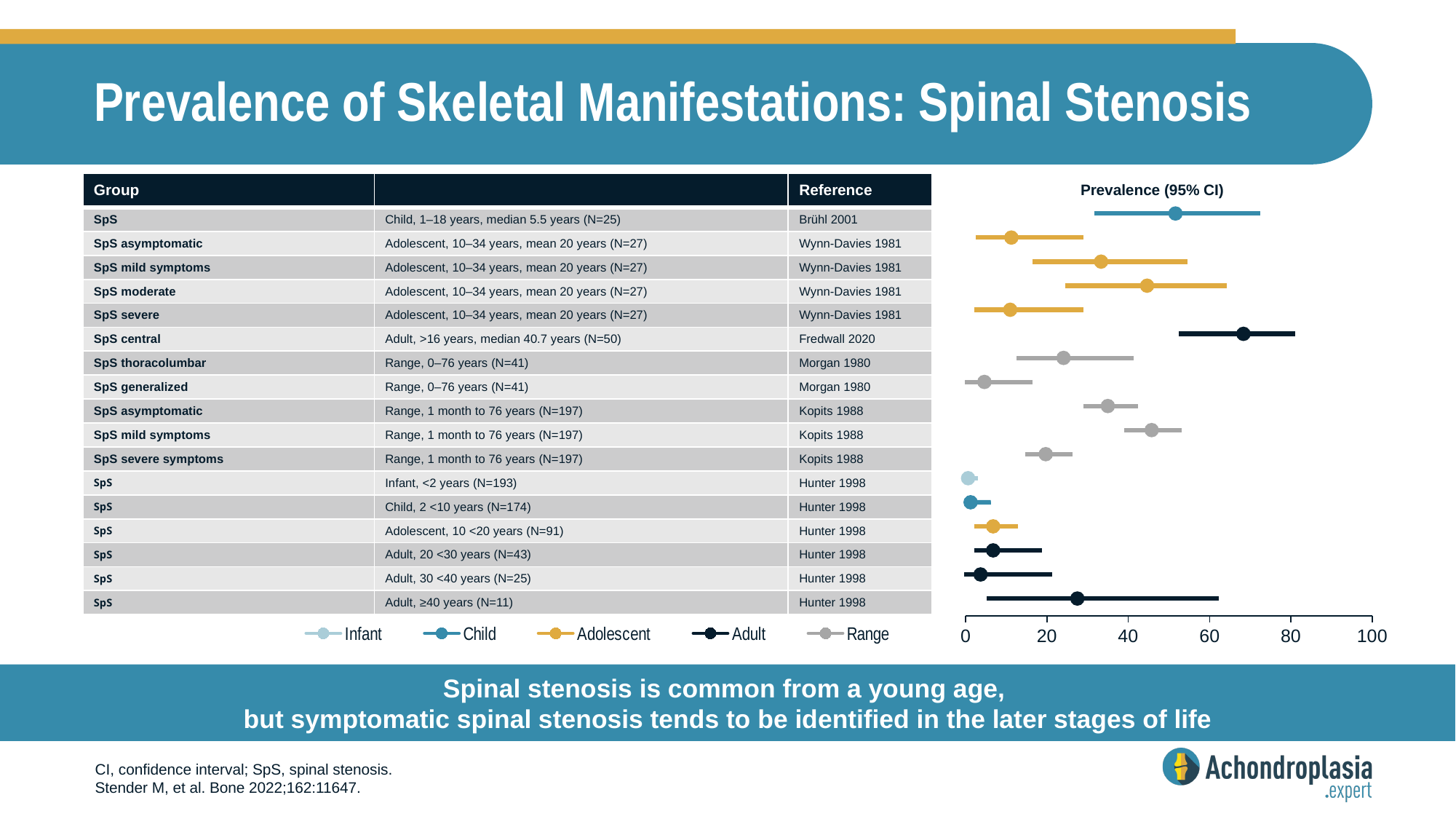
What kind of chart is shown on the right of the slide? A forest plot (dot plot with confidence interval error bars) Which has the larger prevalence point estimate: SpS central (Fredwall 2020) or SpS in children 1–18 years (Brühl 2001)? SpS central (Fredwall 2020) Is the prevalence point estimate for SpS central (Fredwall 2020) greater or less than 60? greater Is the prevalence point estimate for SpS in adults ≥40 years (Hunter 1998) greater or less than 20? greater Which group has the highest prevalence point estimate in the chart? SpS central (Adult, >16 years, Fredwall 2020) Which has the larger prevalence point estimate: SpS mild symptoms (Kopits 1988) or SpS thoracolumbar (Morgan 1980)? SpS mild symptoms (Kopits 1988) What is the title printed above the chart? Prevalence (95% CI) How many series does the chart legend list? 5 How many group rows (point estimates) are plotted in the chart? 17 Is the prevalence point estimate for SpS moderate (Wynn-Davies 1981) greater or less than 40? greater Which series are listed in the chart legend? Infant, Child, Adolescent, Adult, Range